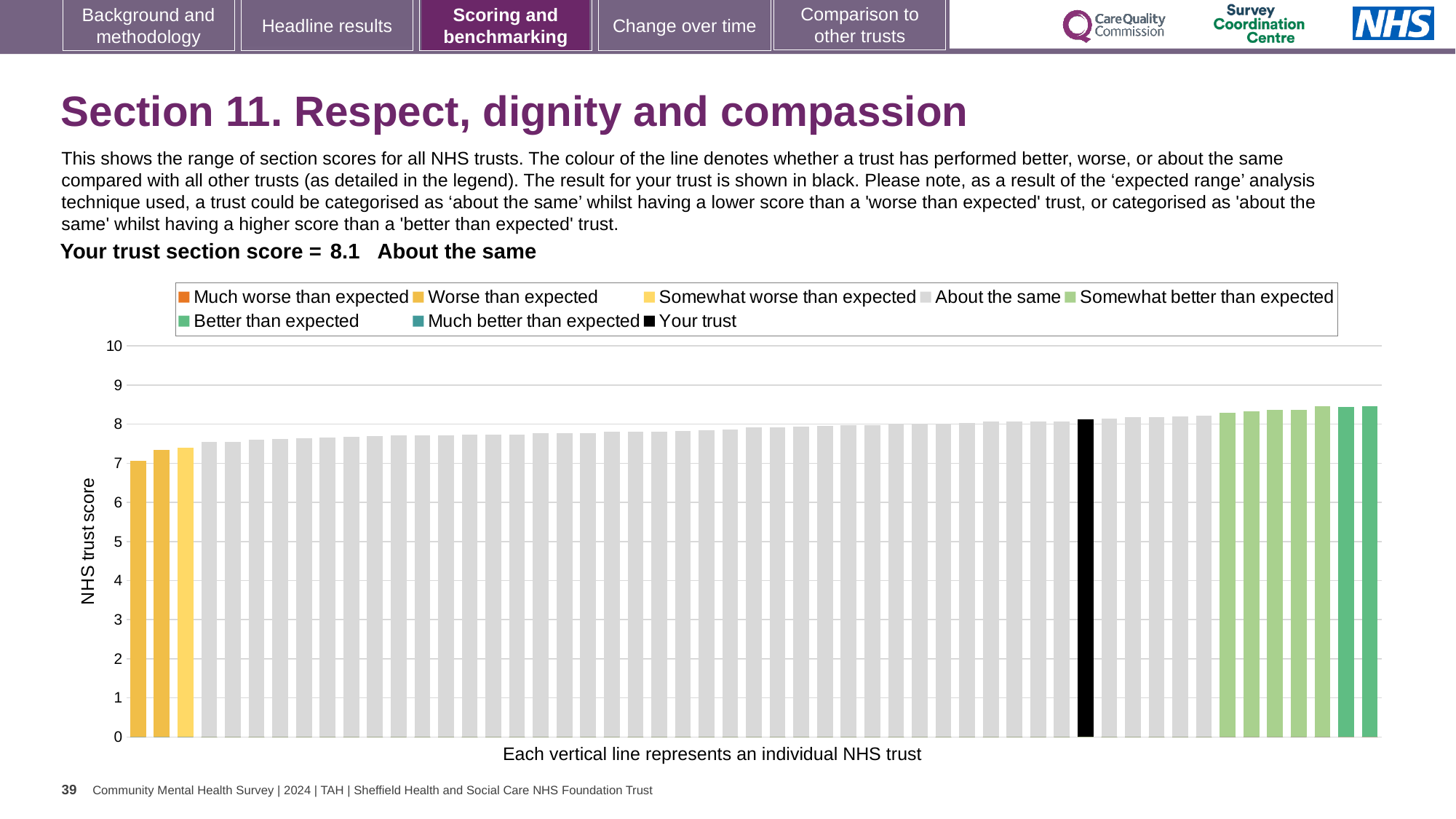
What is the label of the vertical axis? NHS trust score What is the section score for your trust shown on the slide? 8.1 Is the value for your trust (the black bar) greater or less than 8? greater What colour is used for the bar representing your trust? black Is the value of the highest bar greater or less than 9? less Which category does your trust's section score fall into? About the same How many entries does the chart legend list? 8 What kind of chart is shown on the slide? bar chart Is the value of the rightmost bar greater or less than 8? greater Do the bar values rise or fall from left to right along the x axis? rise